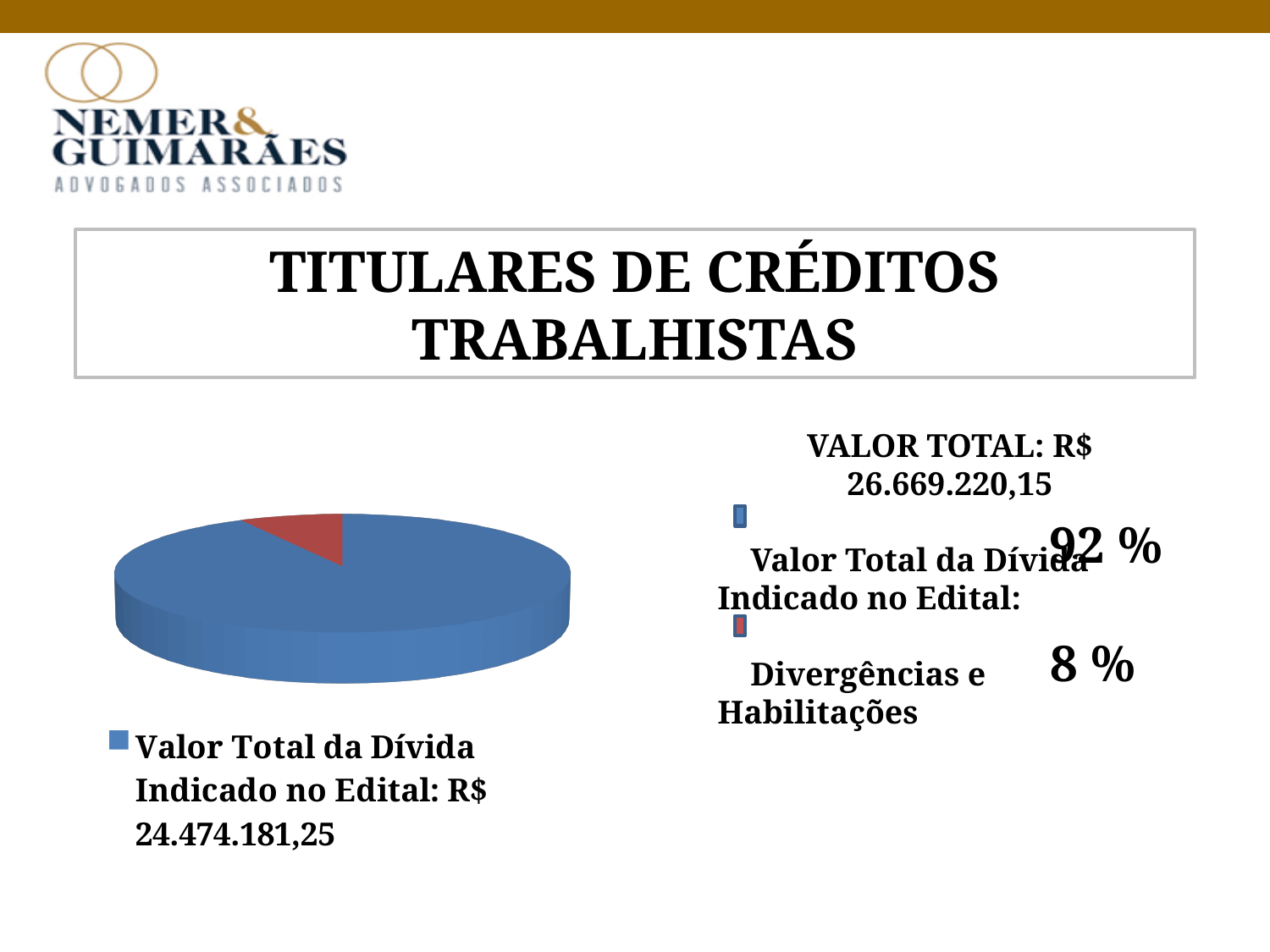
What is the difference in percentage points between the two slices of the pie chart? 84 % Which slice of the pie chart is the smallest? Divergências e Habilitações How many slices does the pie chart have? 2 Which is larger: the share for "Valor Total da Dívida Indicado no Edital" or the share for "Divergências e Habilitações"? Valor Total da Dívida Indicado no Edital What kind of chart is shown on the slide? Pie chart What colour is the slice for "Divergências e Habilitações"? Red What share of the pie does "Valor Total da Dívida Indicado no Edital" represent? 92 % Which slice of the pie chart is the largest? Valor Total da Dívida Indicado no Edital Is the share for "Valor Total da Dívida Indicado no Edital" greater or less than 50%? greater What is the value shown for "Valor Total da Dívida Indicado no Edital"? R$ 24.474.181,25 What share of the pie does "Divergências e Habilitações" represent? 8 % What is the "VALOR TOTAL" shown next to the pie chart? R$ 26.669.220,15